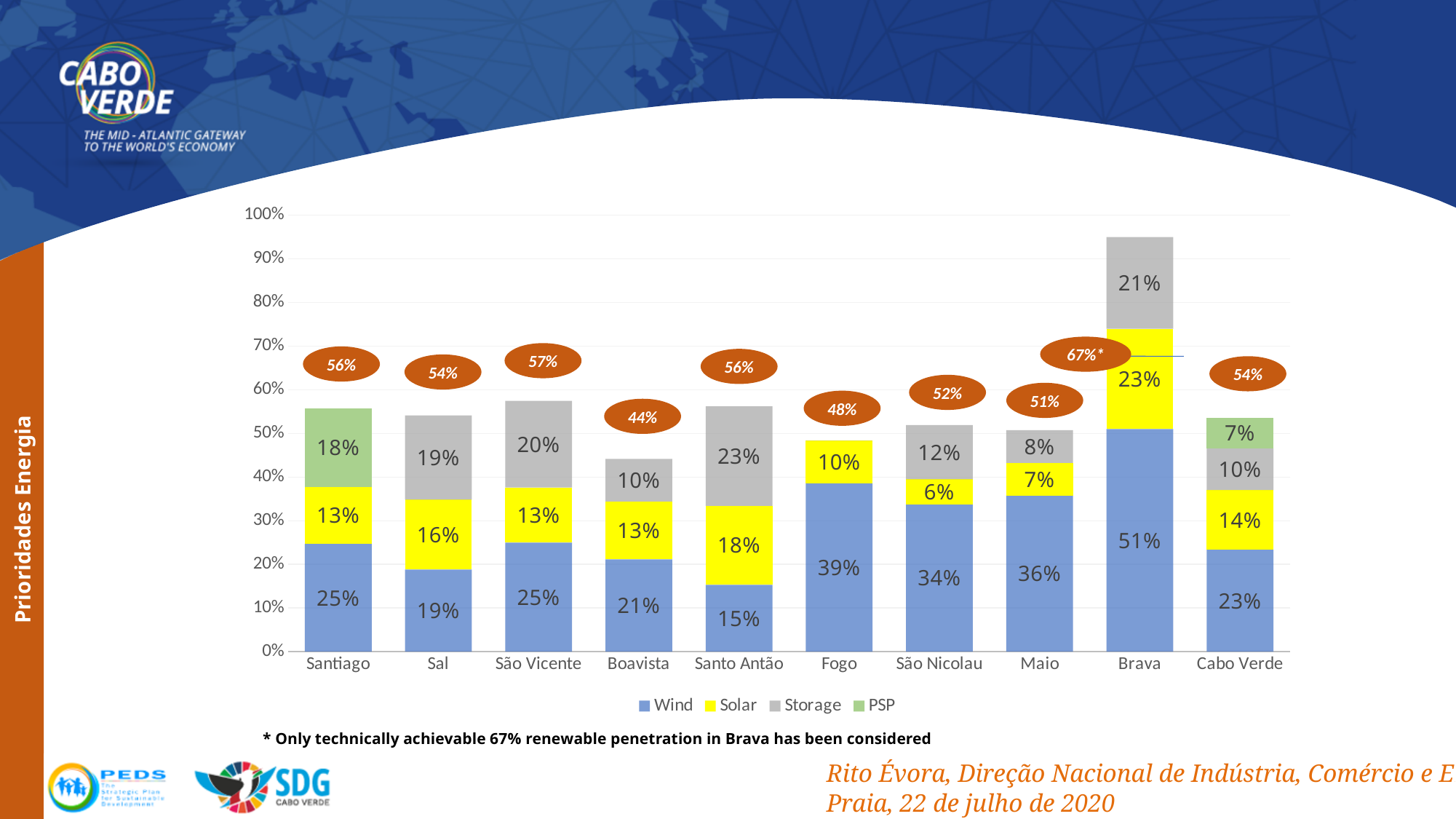
Which category has the highest Wind value? Brava What is the difference between the Solar values for Brava and São Nicolau? 17% Which is larger, the Storage value for Sal or the Storage value for Maio? Sal Which series is shown in yellow in the legend? Solar Which category has the lowest Wind value? Santo Antão What is the total of the stacked bar for Boavista? 44% What is the Storage value for Santo Antão? 23% What kind of chart is shown on the slide? Stacked bar chart How many categories are shown on the x axis? 10 How many series does the legend list? 4 What is the PSP value for Cabo Verde? 7% What is the Wind value for Fogo? 39%